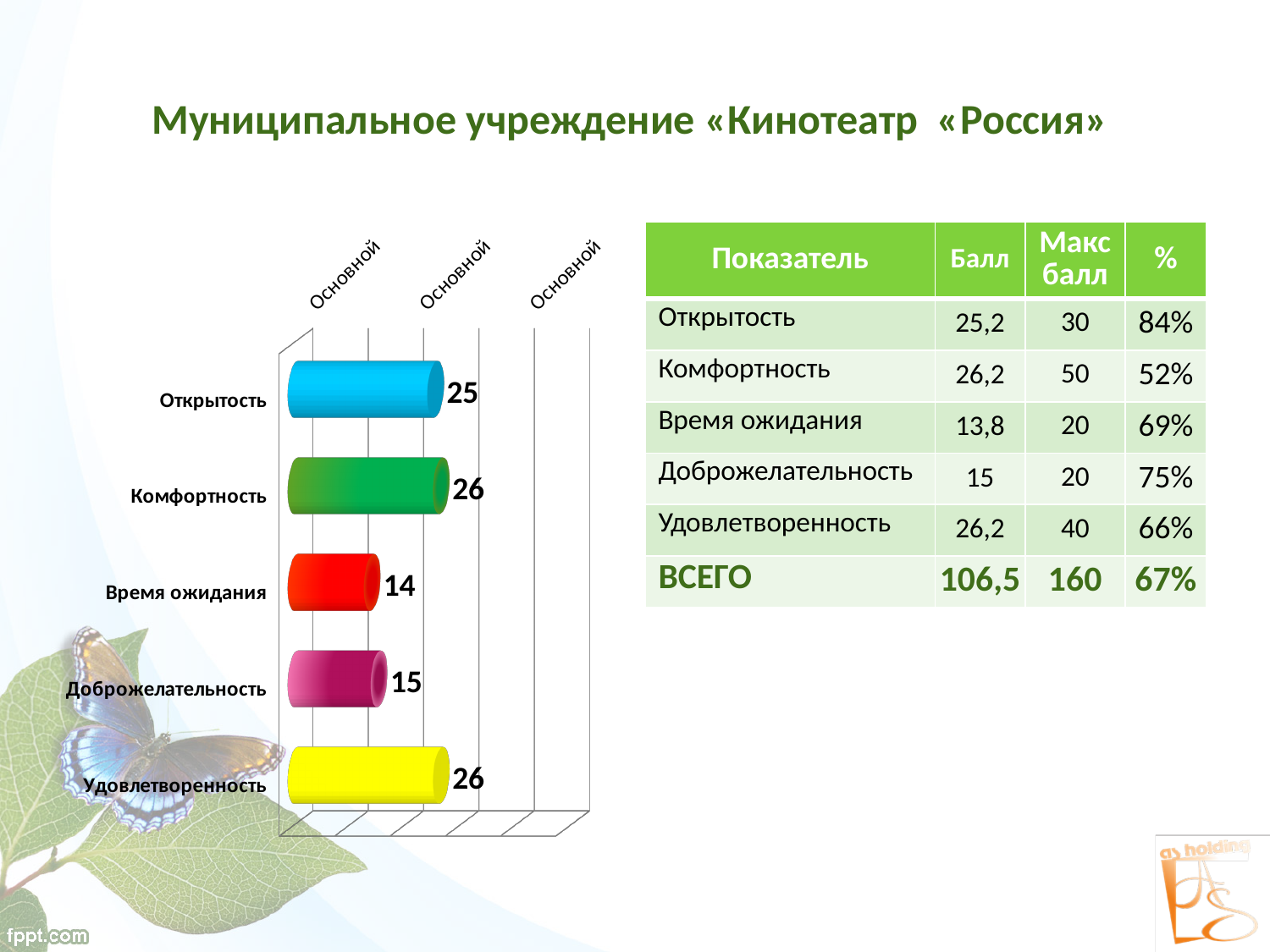
What is the difference between the values for Открытость and Доброжелательность on the chart? 10 Which has a larger value on the chart, Открытость or Время ожидания? Открытость What value is shown for Открытость on the chart? 25 Which has a larger value on the chart, Доброжелательность or Удовлетворенность? Удовлетворенность What value is shown for Доброжелательность on the chart? 15 What type of chart is shown on the slide? Bar chart What is the difference between the values for Комфортность and Время ожидания on the chart? 12 How many categories are shown on the chart? 5 Which category has the lowest value on the chart? Время ожидания What colour is the bar for Время ожидания on the chart? Red What value is shown for Удовлетворенность on the chart? 26 What value is shown for Время ожидания on the chart? 14